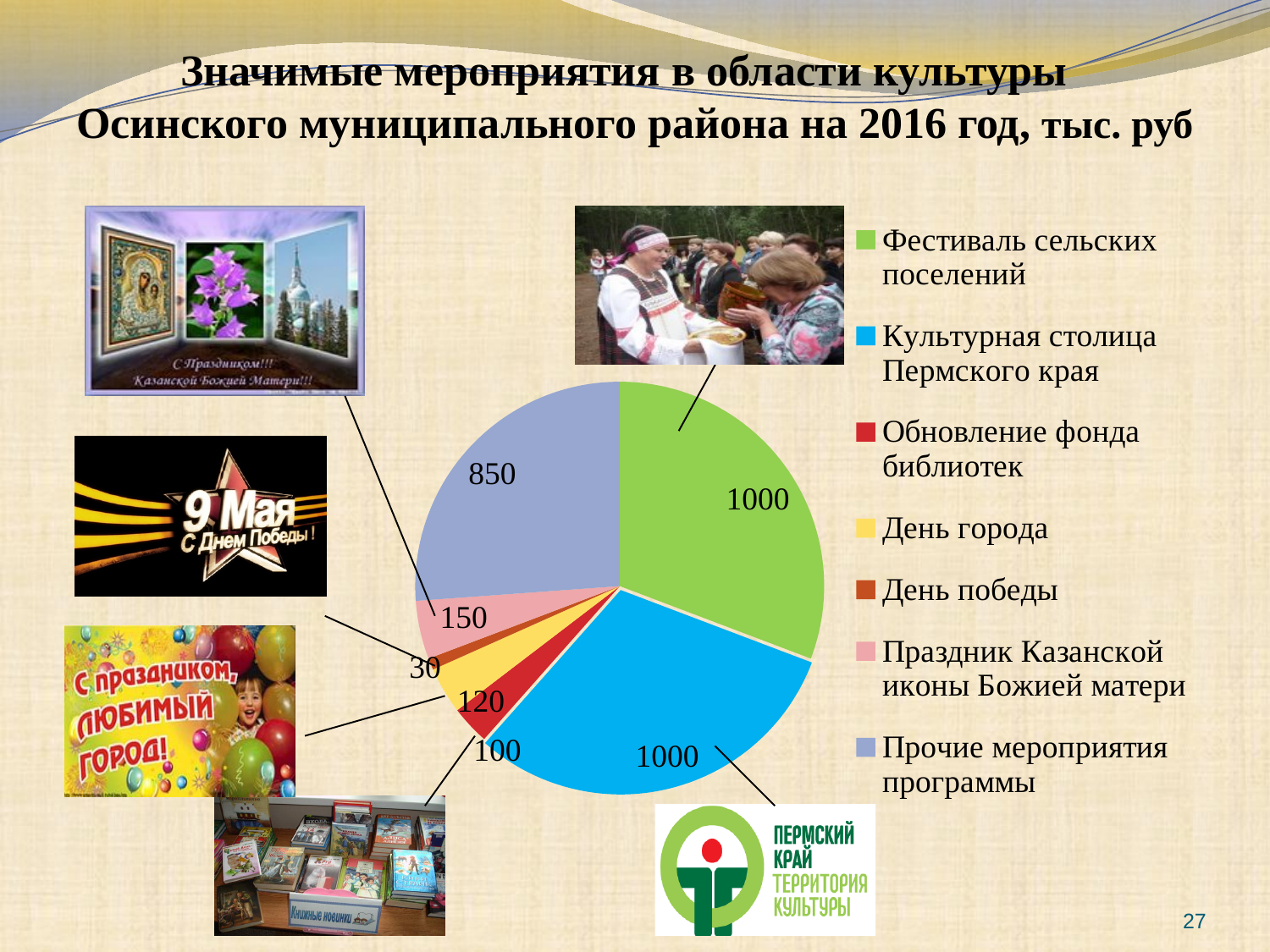
What type of chart is shown on the slide? pie chart What is the difference between the values for Прочие мероприятия программы and Праздник Казанской иконы Божией матери? 700 What is the value for Прочие мероприятия программы? 850 What colour is the slice for Культурная столица Пермского края? blue What is the total of all the values in the pie chart? 3250 Which is larger, the value for День города or the value for Обновление фонда библиотек? День города What is the value for Обновление фонда библиотек? 100 Which category has the smallest slice? День победы What is the value for Праздник Казанской иконы Божией матери? 150 What is the value for День победы? 30 How many categories does the pie chart have? 7 What is the value for Фестиваль сельских поселений? 1000